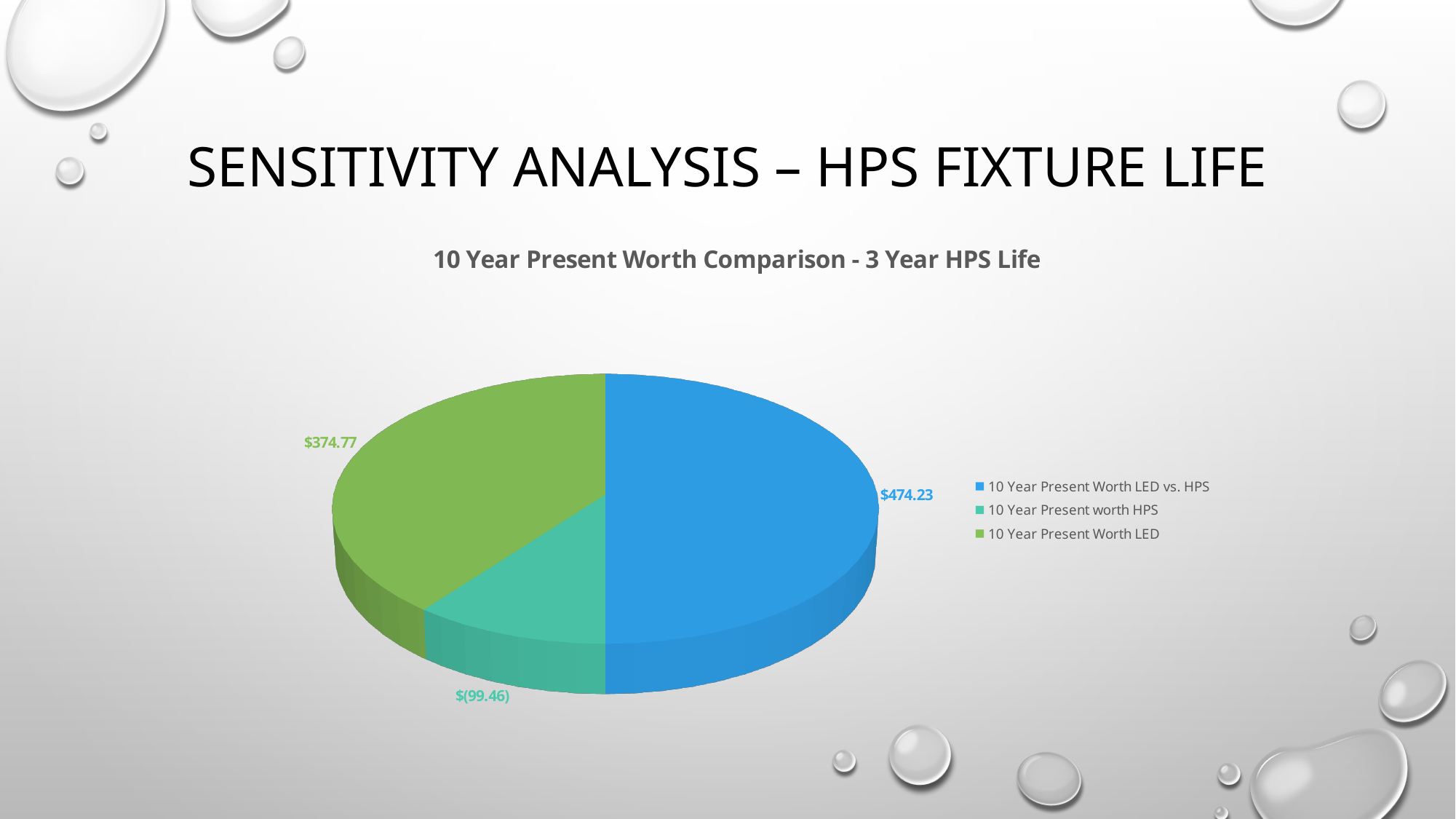
How many slices does the pie chart have? 3 What type of chart is shown on the slide? Pie chart What is the value shown for 10 Year Present Worth LED vs. HPS? $474.23 What colour is the slice for 10 Year Present Worth LED? Green Which is larger, the value for 10 Year Present Worth LED vs. HPS or the value for 10 Year Present Worth LED? 10 Year Present Worth LED vs. HPS How many entries does the legend list? 3 Which category has the largest value in the pie chart? 10 Year Present Worth LED vs. HPS What is the value shown for 10 Year Present worth HPS? $(99.46) What is the value shown for 10 Year Present Worth LED? $374.77 What is the difference between the value for 10 Year Present Worth LED vs. HPS and the value for 10 Year Present Worth LED? $99.46 What is the title of the chart? 10 Year Present Worth Comparison - 3 Year HPS Life Which category has the smallest value in the pie chart? 10 Year Present worth HPS